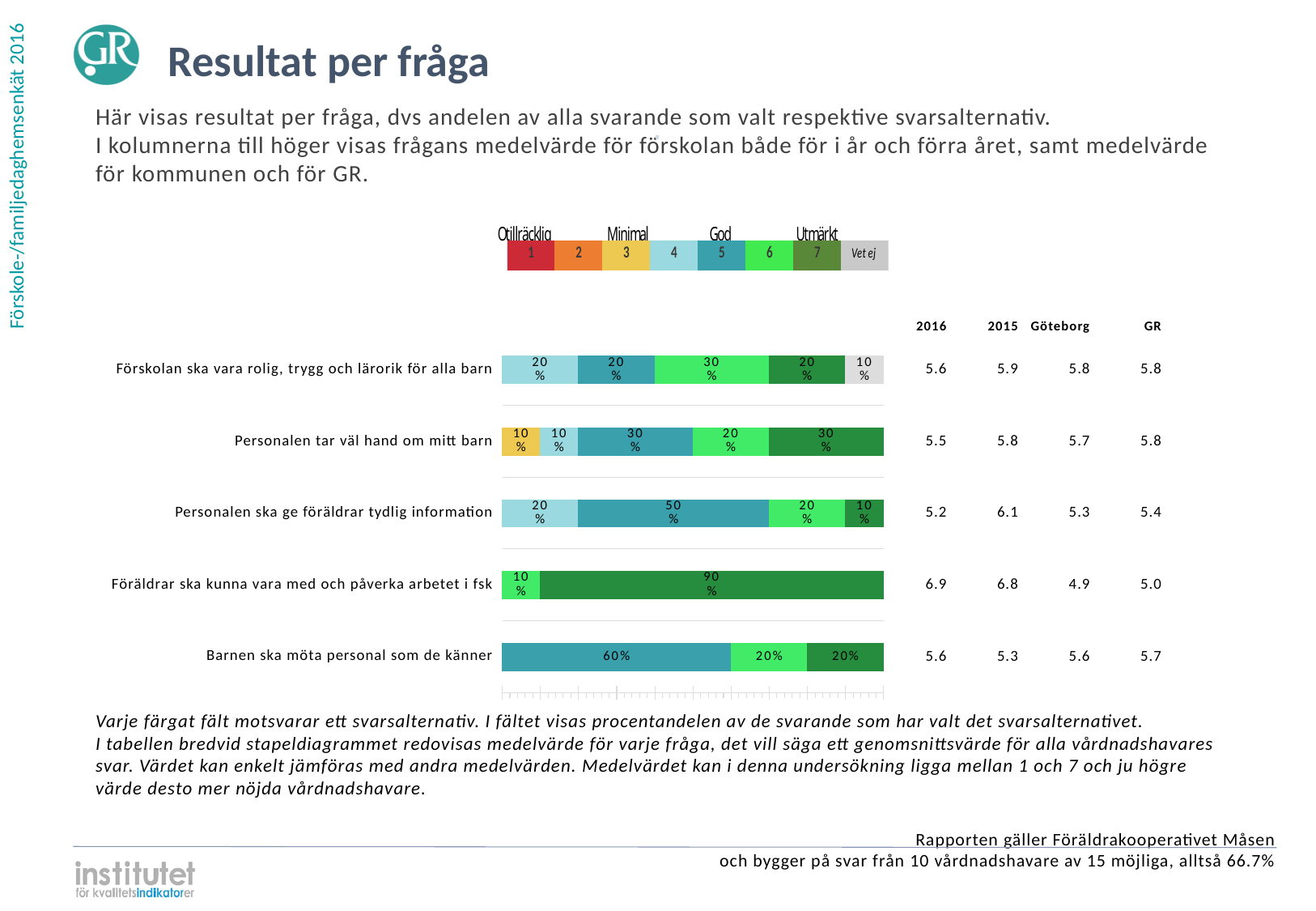
What percentage of respondents chose answer 5 for 'Personalen ska ge föräldrar tydlig information'? 50% What percentage of respondents chose answer 7 for 'Föräldrar ska kunna vara med och påverka arbetet i fsk'? 90% How many answer alternatives does the legend above the chart list, including 'Vet ej'? 8 Which question has the largest single segment in its bar? Föräldrar ska kunna vara med och påverka arbetet i fsk For 'Personalen tar väl hand om mitt barn', which is larger: the share choosing answer 5 or the share choosing answer 6? Answer 5 What is the difference between the share choosing answer 7 and the share choosing answer 6 for 'Föräldrar ska kunna vara med och påverka arbetet i fsk'? 80% What is the GR mean value shown for 'Personalen ska ge föräldrar tydlig information'? 5.4 What percentage of respondents answered 'Vet ej' for 'Förskolan ska vara rolig, trygg och lärorik för alla barn'? 10% What is the 2016 mean value shown for 'Föräldrar ska kunna vara med och påverka arbetet i fsk'? 6.9 How many questions (categories) are shown in the bar chart? 5 What kind of chart is used to show the results per question? Stacked bar chart What percentage of respondents chose answer 5 for 'Barnen ska möta personal som de känner'? 60%